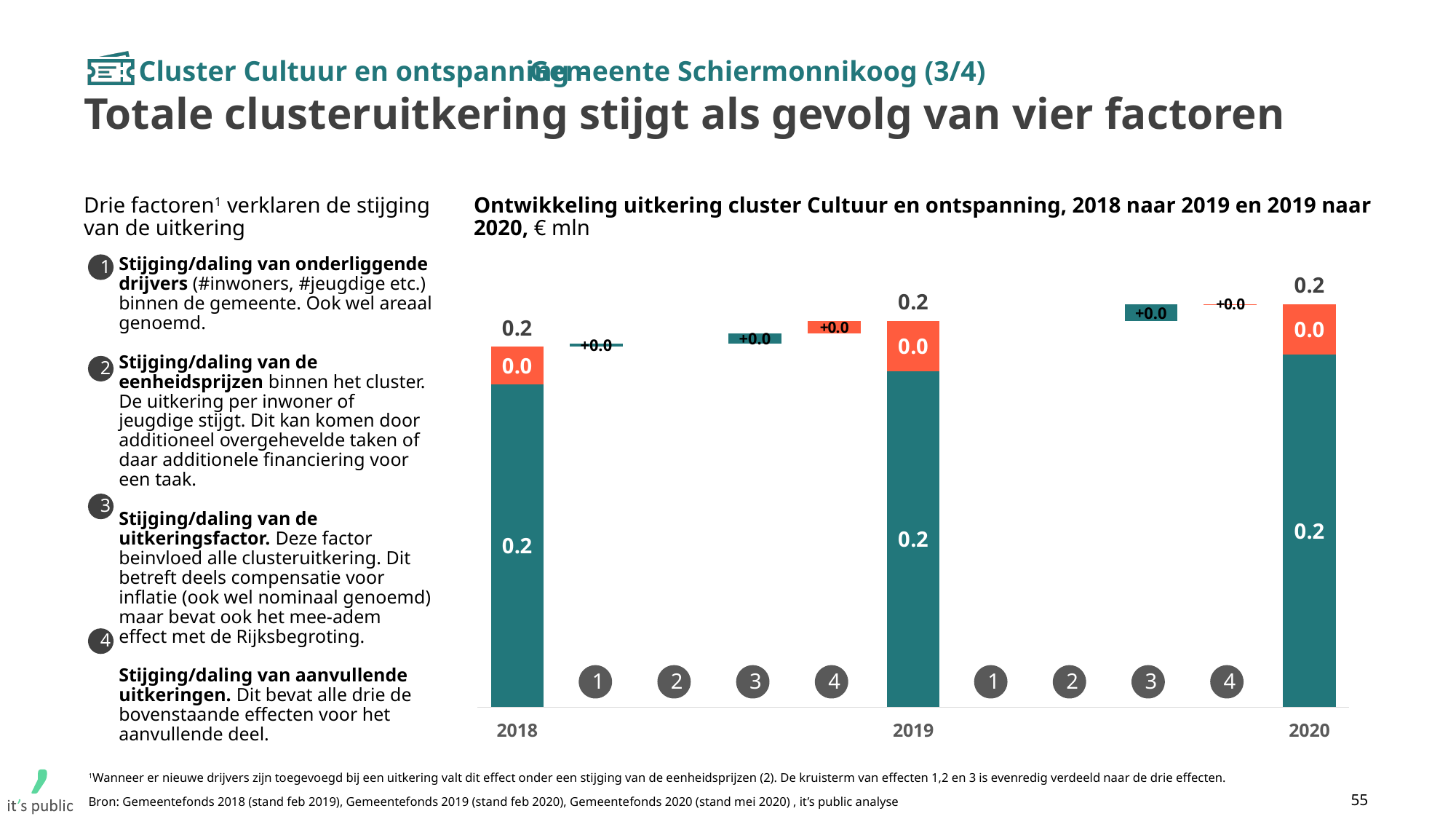
What is the value of the teal (lower) segment of the 2019 bar? 0.2 How many years are shown as full bars on the chart? 3 What is the total value of the 2018 bar? 0.2 What is the total value of the 2020 bar? 0.2 Do the yearly totals rise, fall or stay the same from 2018 to 2020? rise How many numbered factor steps are shown between 2019 and 2020? 4 In what unit are the chart values expressed? € mln What is the value shown for factor 4 between 2019 and 2020? +0.0 What is the value of the orange (upper) segment of the 2020 bar? 0.0 What is the difference between the total for 2019 and the total for 2018? 0.0 What kind of chart is shown on the slide? bar chart What is the value shown for factor 1 between 2018 and 2019? +0.0